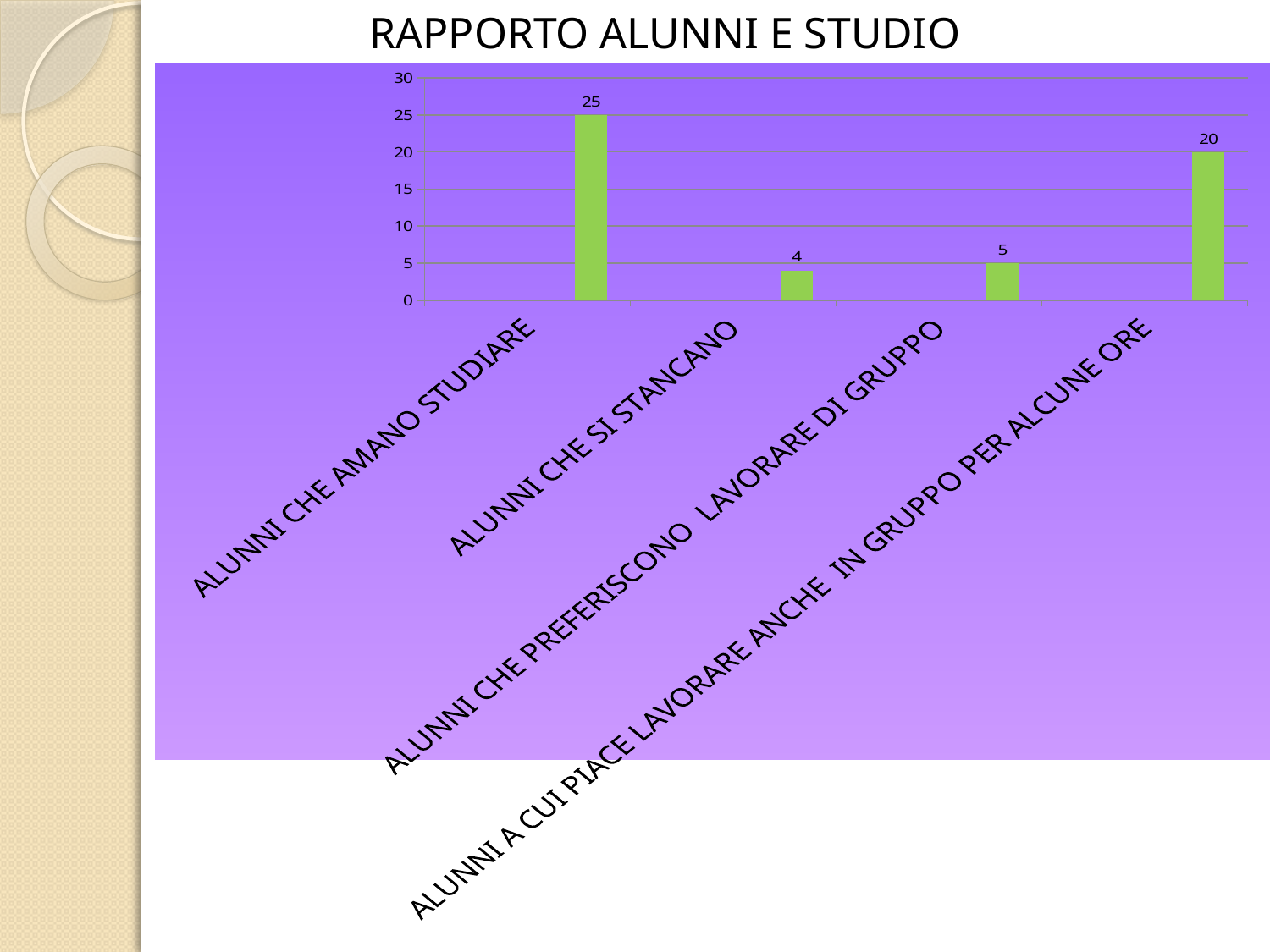
What is the value for ALUNNI CHE AMANO STUDIARE? 25 What is the value for ALUNNI CHE SI STANCANO? 4 What is the value for ALUNNI CHE PREFERISCONO LAVORARE DI GRUPPO? 5 Is the value for ALUNNI A CUI PIACE LAVORARE ANCHE IN GRUPPO PER ALCUNE ORE greater or less than 15? greater What is the title of the slide? RAPPORTO ALUNNI E STUDIO How many categories are shown in the chart? 4 What is the difference between the values for ALUNNI CHE AMANO STUDIARE and ALUNNI A CUI PIACE LAVORARE ANCHE IN GRUPPO PER ALCUNE ORE? 5 What kind of chart is shown on the slide? bar chart What is the value for ALUNNI A CUI PIACE LAVORARE ANCHE IN GRUPPO PER ALCUNE ORE? 20 Which category has the highest value? ALUNNI CHE AMANO STUDIARE Which category has the lowest value? ALUNNI CHE SI STANCANO Which is larger, the value for ALUNNI CHE SI STANCANO or the value for ALUNNI CHE PREFERISCONO LAVORARE DI GRUPPO? ALUNNI CHE PREFERISCONO LAVORARE DI GRUPPO